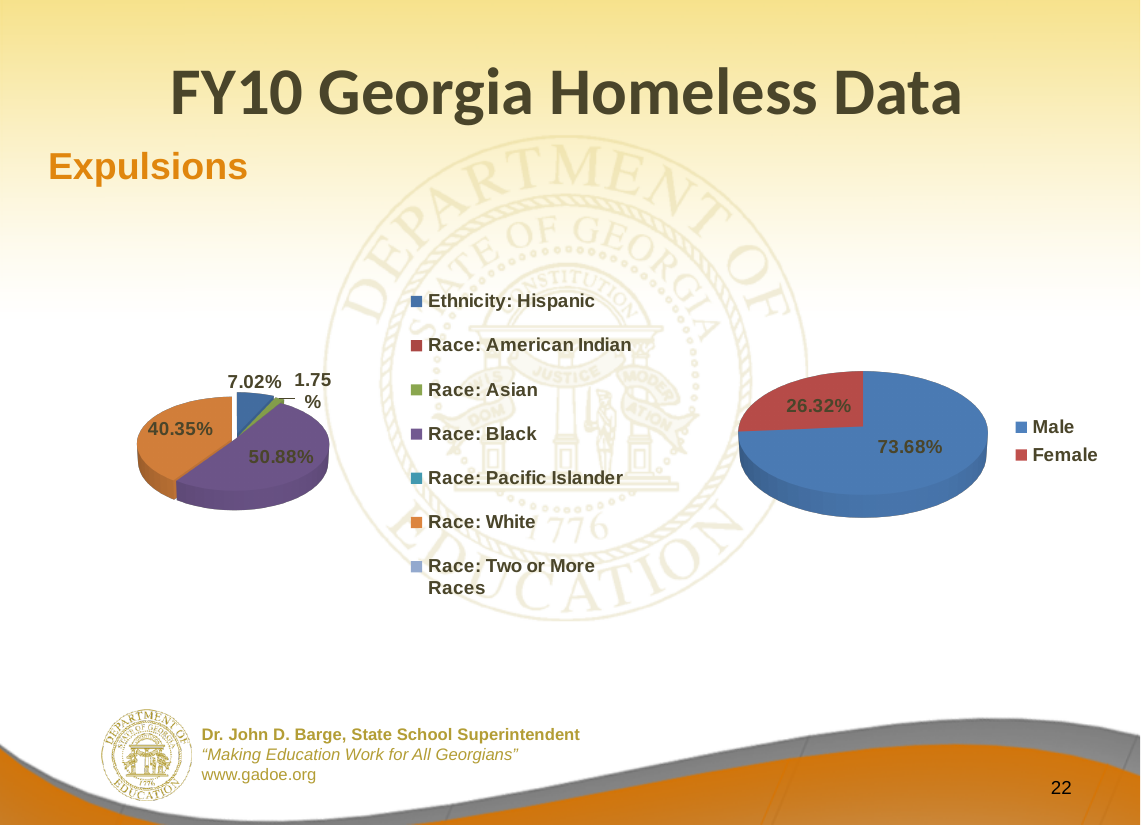
On the left pie chart, what is the difference between the Race: Black and Race: White shares? 10.53% On the left pie chart, what share is shown for Race: Asian? 1.75% On the left pie chart, what share is shown for Ethnicity: Hispanic? 7.02% What type of chart is the right chart on the slide? Pie chart On the left pie chart, what share is shown for Race: Black? 50.88% On the right pie chart, which is larger, Male or Female? Male On the right pie chart, what share is shown for Female? 26.32% On the right pie chart, what share is shown for Male? 73.68% On the left pie chart, which category has the largest slice? Race: Black On the left pie chart, how many entries does the legend list? 7 On the right pie chart, what is the difference between the Male and Female shares? 47.36% On the left pie chart, what share is shown for Race: White? 40.35%